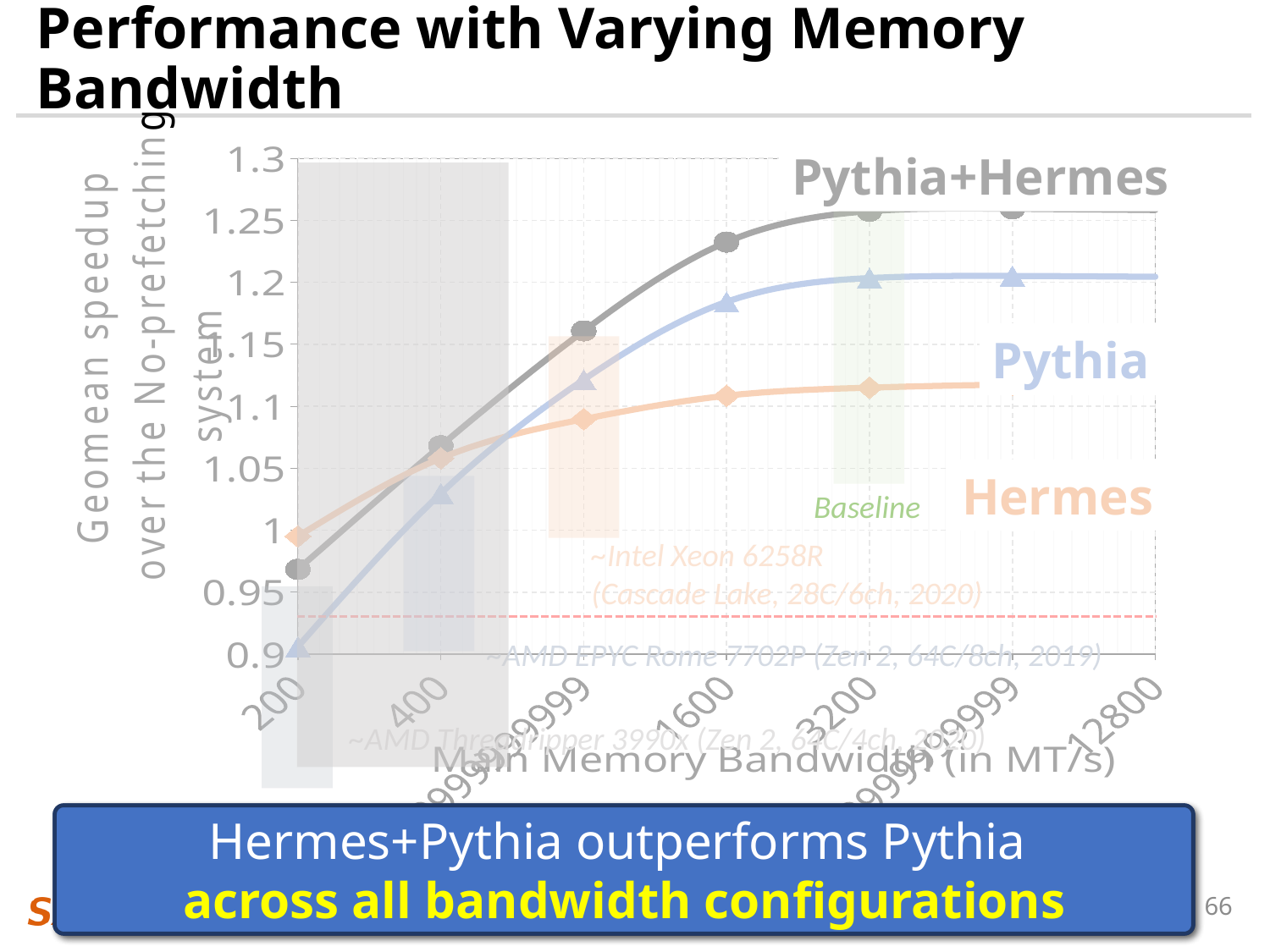
Is the value for Hermes at 3200 MT/s greater or less than 1.15? less What kind of chart is shown on the slide? line chart Does the Pythia+Hermes series rise or fall as memory bandwidth increases along the x axis? rise Is the value for Pythia at 3200 MT/s greater or less than 1.15? greater How many series are plotted on the chart? 3 Is the value for Pythia at 200 MT/s greater or less than 0.95? less What is the title of the x axis? Main Memory Bandwidth (in MT/s) At 1600 MT/s, which series has the larger value, Pythia+Hermes or Pythia? Pythia+Hermes At 200 MT/s, which series has the larger value, Hermes or Pythia? Hermes Which series has the highest value at 3200 MT/s? Pythia+Hermes What is the title of the y axis? Geomean speedup over the No-prefetching system